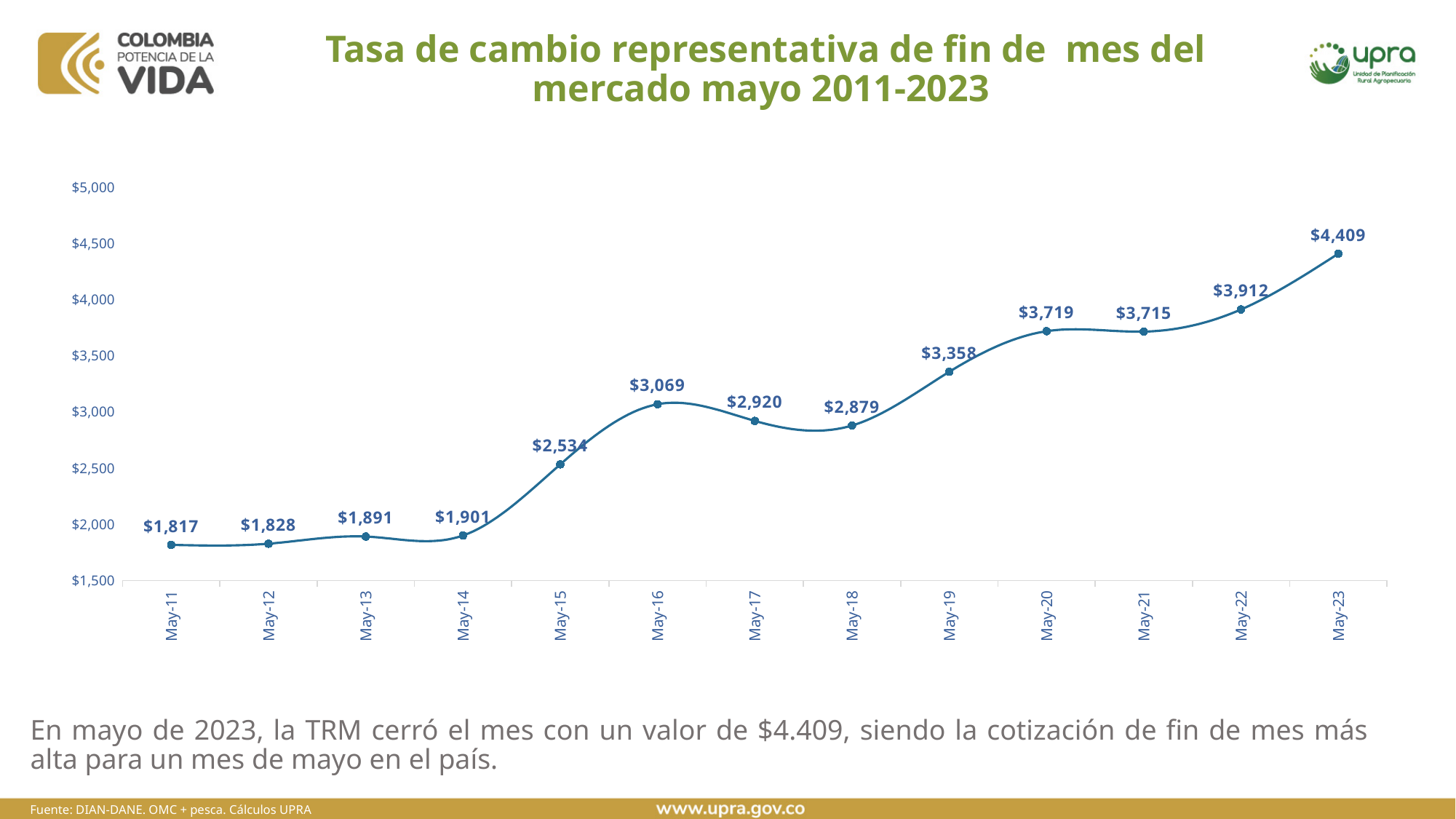
What is the difference between the values for May-16 and May-15? $535 What is the value for May-11? $1,817 How many data points are plotted on the chart? 13 Which point has the highest value? May-23 Which is larger, the value for May-17 or the value for May-18? May-17 Which point has the lowest value? May-11 What kind of chart is shown on the slide? line chart Do the values generally rise or fall from May-11 to May-23? rise Is the value for May-20 greater or less than $3,500? greater What is the value for May-16? $3,069 What is the difference between the values for May-23 and May-22? $497 What is the value for May-19? $3,358